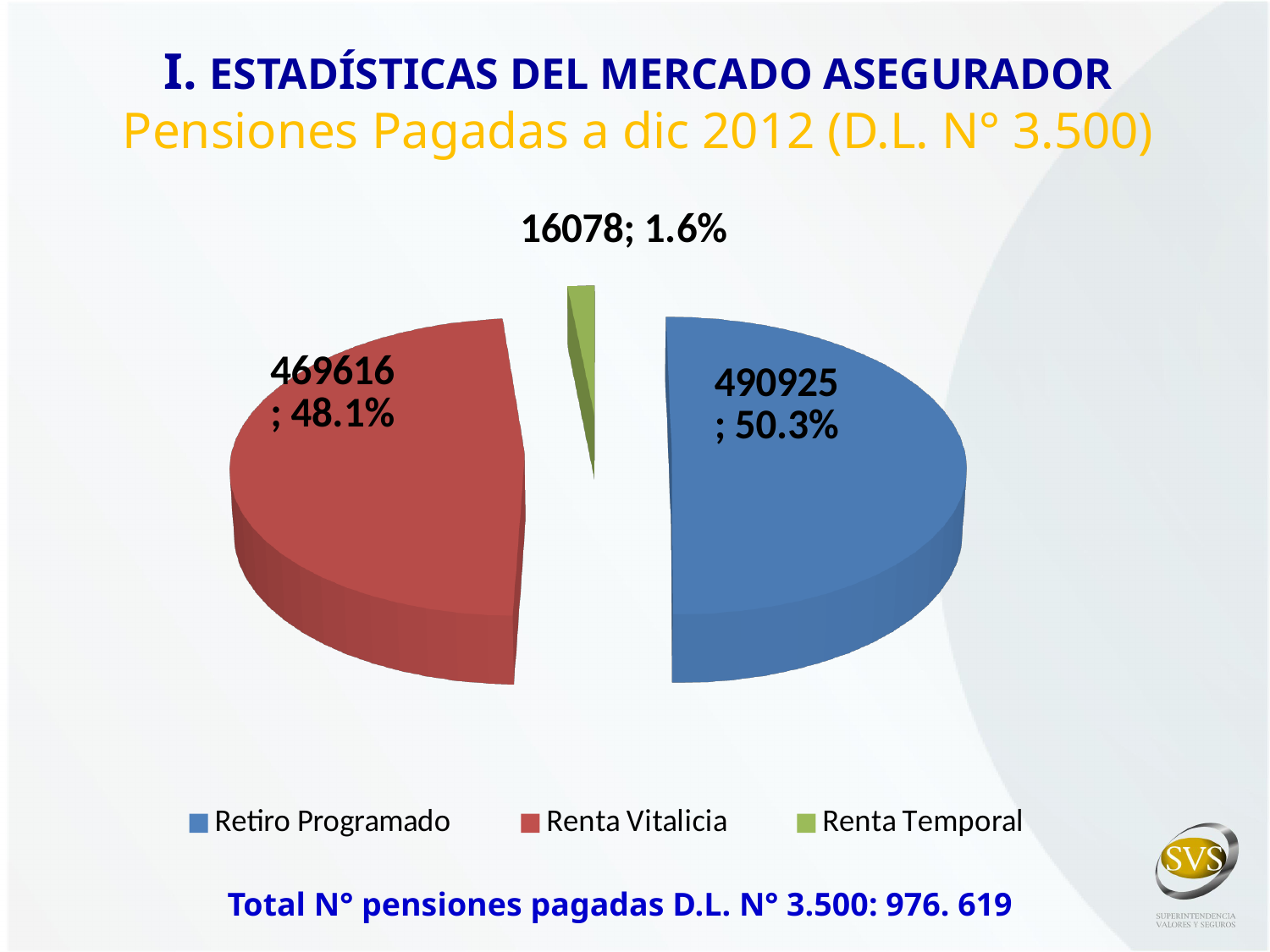
Which category has the smallest slice of the pie? Renta Temporal How many slices does the pie chart have? 3 What is the value shown for Retiro Programado? 490925 Which category has the largest slice of the pie? Retiro Programado What share of the pie does Retiro Programado represent? 50.3% What is the value shown for Renta Temporal? 16078 Which colour represents Renta Vitalicia in the pie chart? Red What type of chart is shown on the slide? Pie chart What share of the pie does Renta Temporal represent? 1.6% What is the value shown for Renta Vitalicia? 469616 How many entries does the legend list? 3 What is the difference between the values for Retiro Programado and Renta Vitalicia? 21309